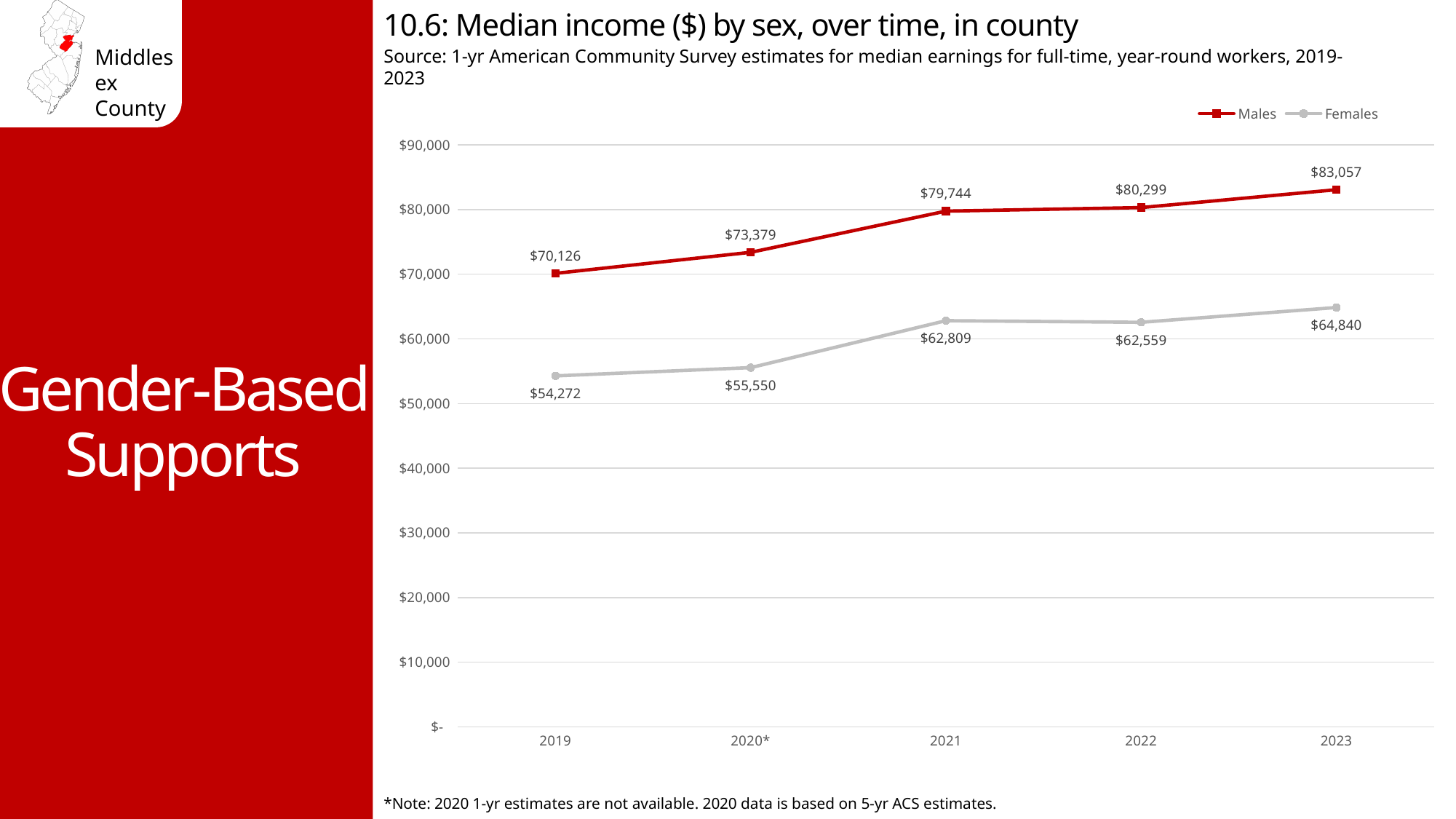
What is the difference between the Males median income in 2022 and 2021? $555 How many years are shown on the x axis? 5 In which year was the median income for Males highest? 2023 What was the median income for Females in 2019? $54,272 What was the median income for Females in 2023? $64,840 What is the difference between the Males and Females median income in 2023? $18,217 How many series does the legend list? 2 What kind of chart is shown on the slide? line chart Which was higher in 2020*, the median income for Males or for Females? Males What was the median income for Males in 2021? $79,744 In which year was the median income for Females lowest? 2019 Is the median income for Females in 2021 greater or less than $60,000? greater